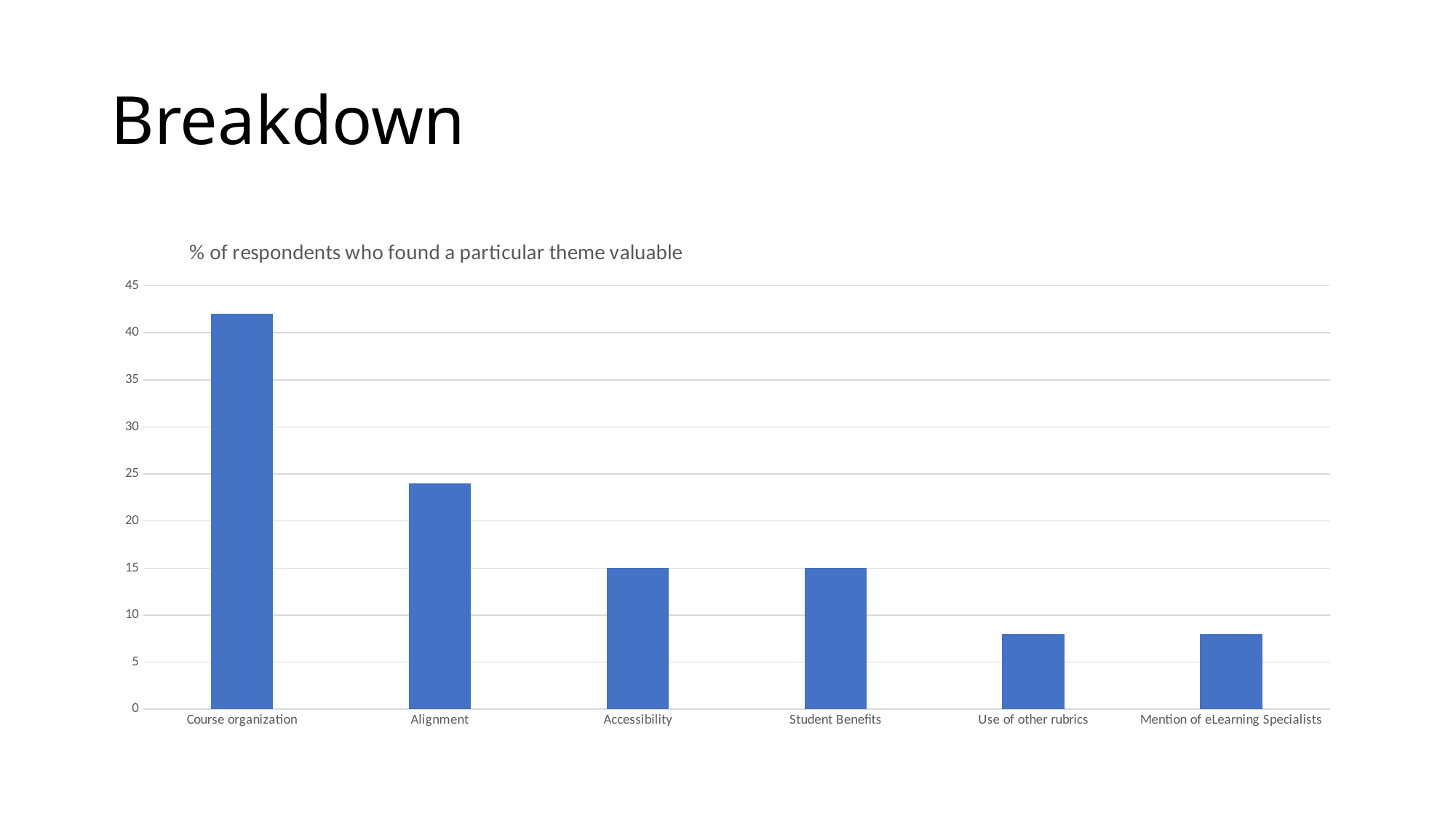
Is the value for Alignment greater or less than 25? less Is the value for Use of other rubrics greater or less than 10? less What is the title of the chart? % of respondents who found a particular theme valuable Is the value for Course organization greater or less than 40? greater Which theme has the highest percentage of respondents who found it valuable? Course organization What is the value for Accessibility? 15 How many themes (categories) are shown on the x axis? 6 Which is larger, the value for Alignment or the value for Accessibility? Alignment What is the value for Student Benefits? 15 Do the values generally rise or fall moving from left to right along the x axis? fall What kind of chart is shown on the slide? bar chart